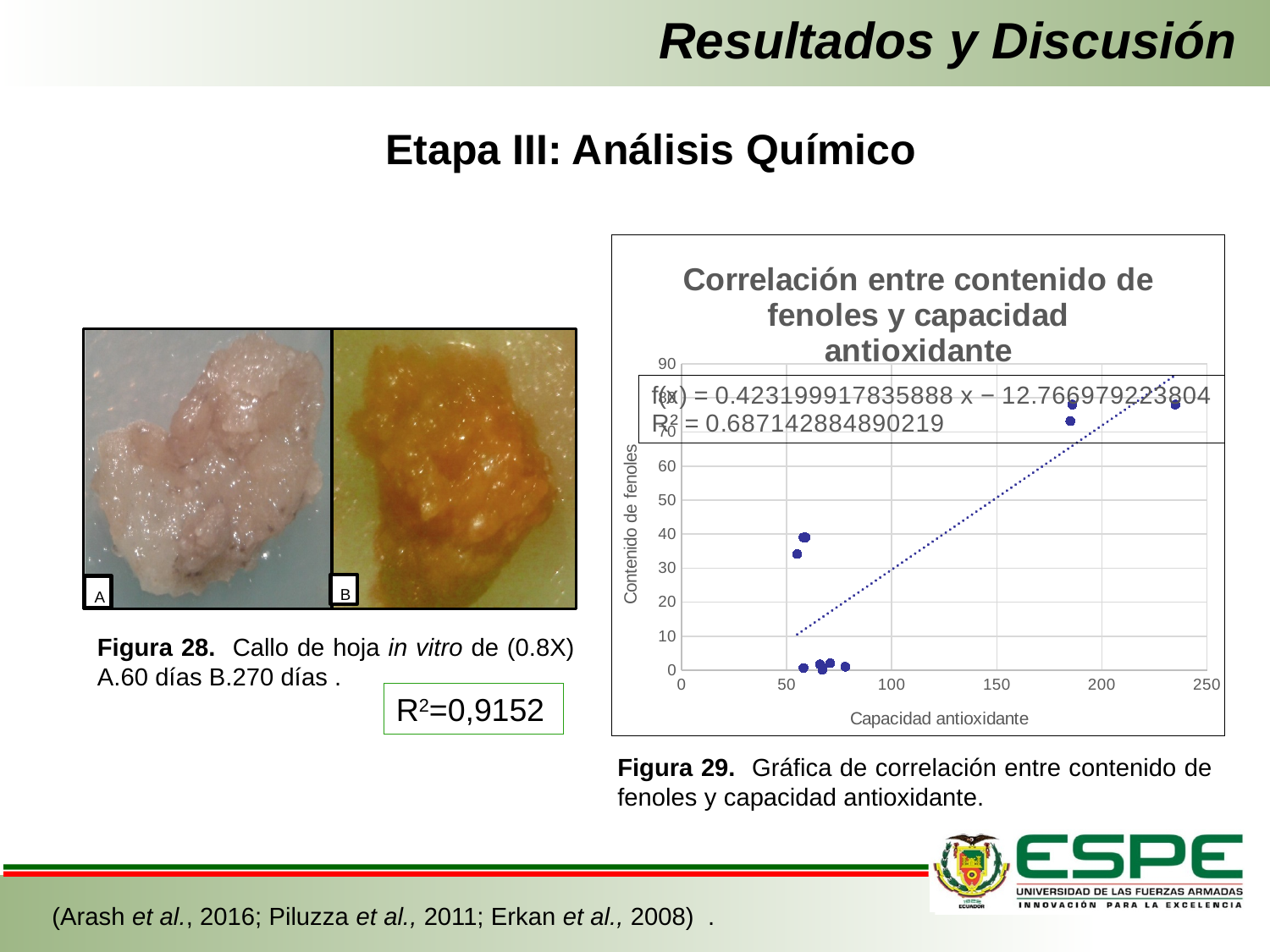
Is the Contenido de fenoles value for the point with the highest Capacidad antioxidante (near 235) greater or less than 70? greater Is the Contenido de fenoles value for the point near Capacidad antioxidante 55 greater or less than 30? greater What kind of chart is shown in Figura 29? scatter chart Does the trendline on the chart rise or fall as Capacidad antioxidante increases? rise What is the slope of the trendline equation printed on the chart? 0.423199917835888 Are the Contenido de fenoles values for the cluster of points between 60 and 80 on the x axis greater or less than 10? less Which has a higher Contenido de fenoles: the point near Capacidad antioxidante 185 or the point near 60? the point near 185 What is the maximum value shown on the y axis of the chart? 90 What R² value is printed on the chart's trendline label? 0.687142884890219 What is the title of the chart on the slide? Correlación entre contenido de fenoles y capacidad antioxidante What is the label of the x axis of the chart? Capacidad antioxidante